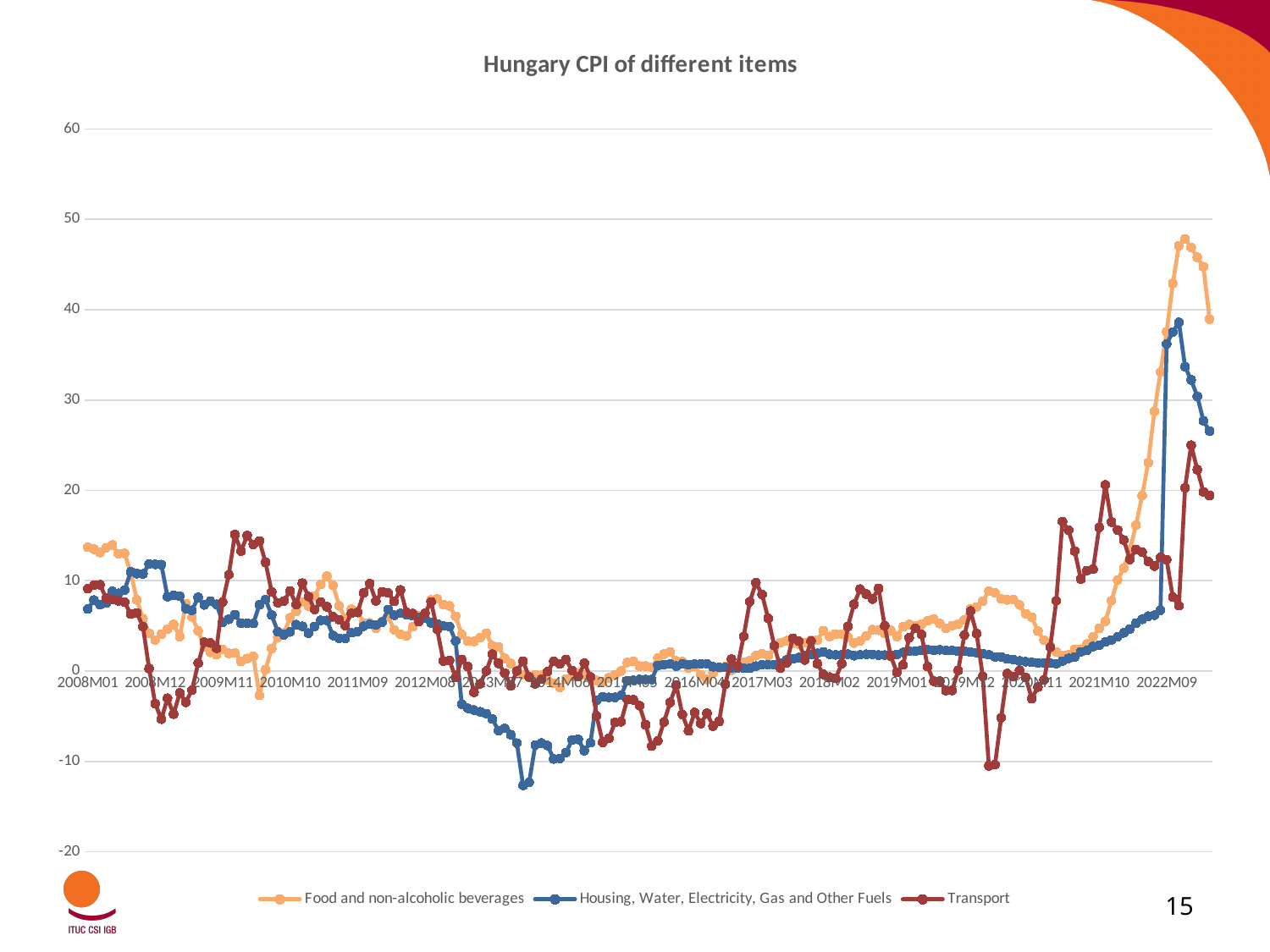
Does the Food and non-alcoholic beverages series rise or fall between 2021M10 and 2022M09? rise At 2022M09, which series has the larger value: Food and non-alcoholic beverages or Transport? Food and non-alcoholic beverages Which series is shown in orange in the legend? Food and non-alcoholic beverages What is the title of the chart? Hungary CPI of different items Which series reaches the highest value on the chart? Food and non-alcoholic beverages Is the peak value of the Housing, Water, Electricity, Gas and Other Fuels series greater or less than 30? greater What kind of chart is shown on the slide? line chart Is the peak value of the Food and non-alcoholic beverages series greater or less than 40? greater Is the value of Food and non-alcoholic beverages at 2008M01 greater or less than 10? greater How many series does the legend list? 3